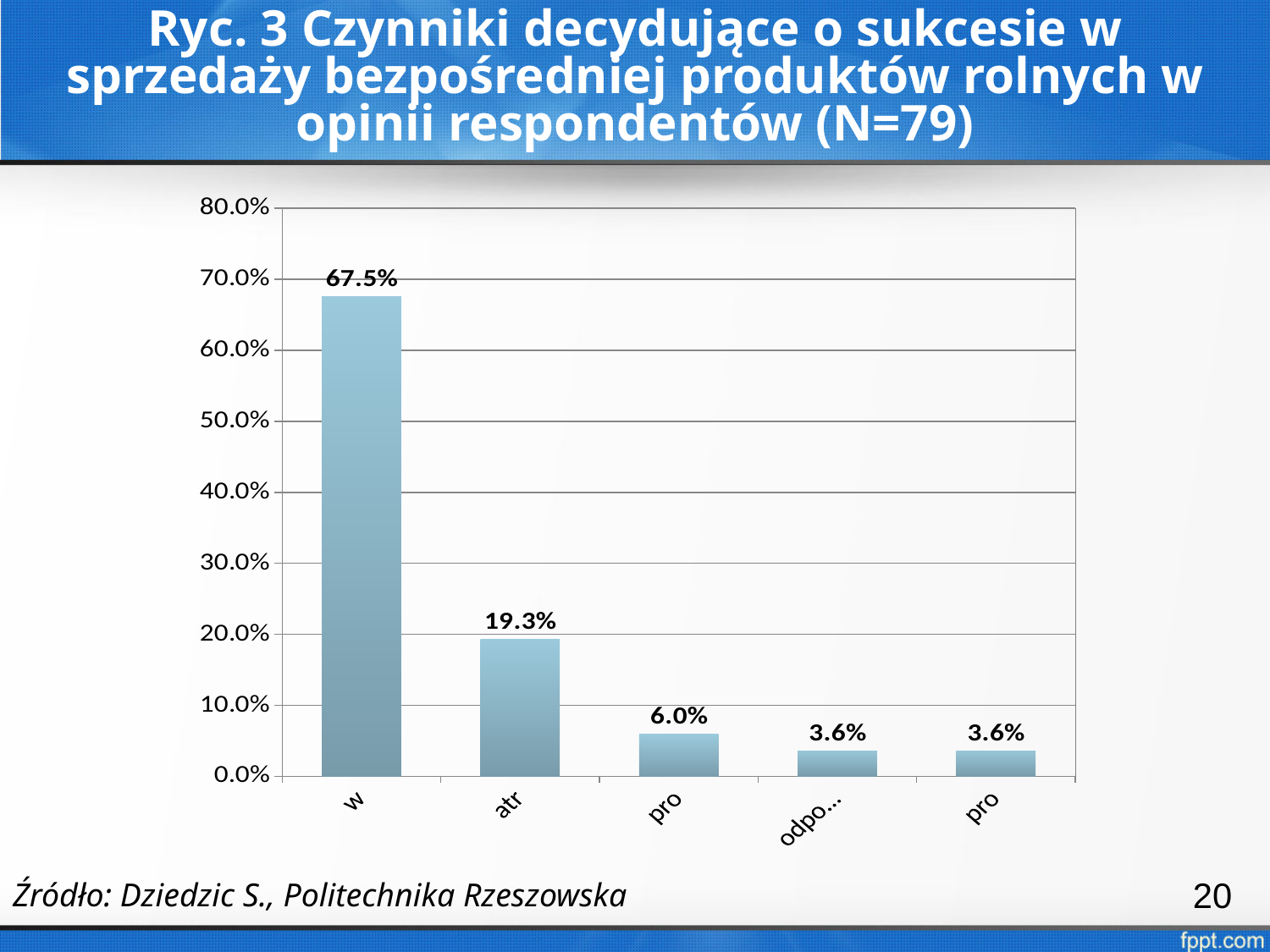
What is the difference between the first bar (67.5%) and the second bar (19.3%)? 48.2% What is the value of the third bar from the left in the chart? 6.0% What is the value of the first (leftmost) bar in the chart? 67.5% What is the value of the rightmost bar in the chart? 3.6% What is the value of the second bar from the left in the chart? 19.3% What is the lowest value shown in the chart? 3.6% What kind of chart is shown on the slide? bar chart What is the highest value shown in the chart? 67.5% Is the value of the first bar greater or less than 60.0%? greater How many bars are shown in the chart? 5 Which is larger, the second bar from the left or the third bar from the left? the second bar Do the bar values rise or fall from left to right across the chart? fall